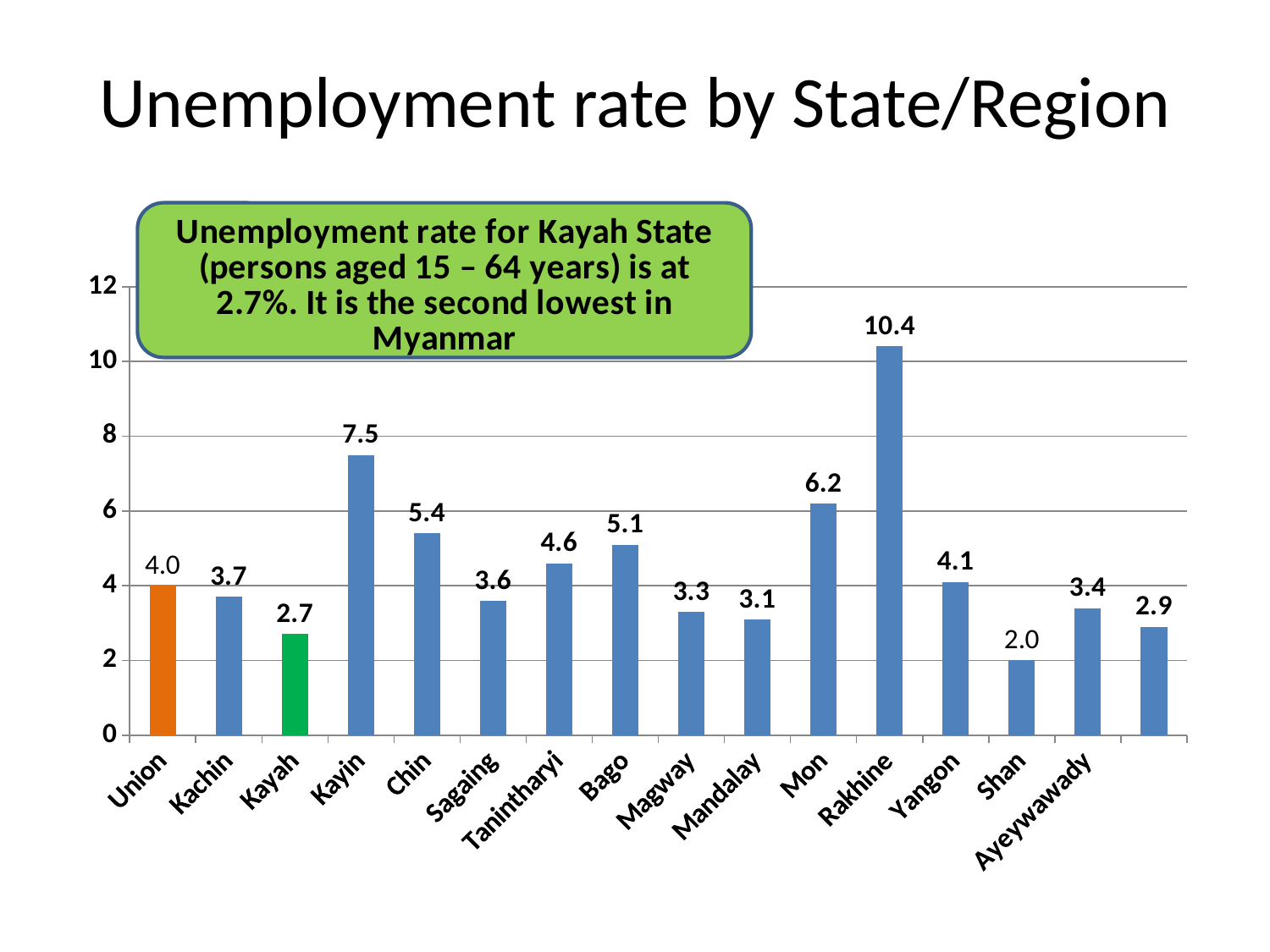
Which has a lower unemployment rate, Magway or Mandalay? Mandalay What is the value shown for Union? 4.0 What kind of chart is shown on the slide? Bar chart What is the unemployment rate for Rakhine? 10.4 What is the unemployment rate for Kayah? 2.7 Which state or region has the lowest unemployment rate? Shan Which has a higher unemployment rate, Mon or Bago? Mon What is the difference between the unemployment rates of Kayin and Chin? 2.1 How many states/regions (including Union) are shown on the x axis? 15 What is the difference between the unemployment rates of Rakhine and Shan? 8.4 What colour is the bar for Kayah? Green Which state or region has the highest unemployment rate? Rakhine